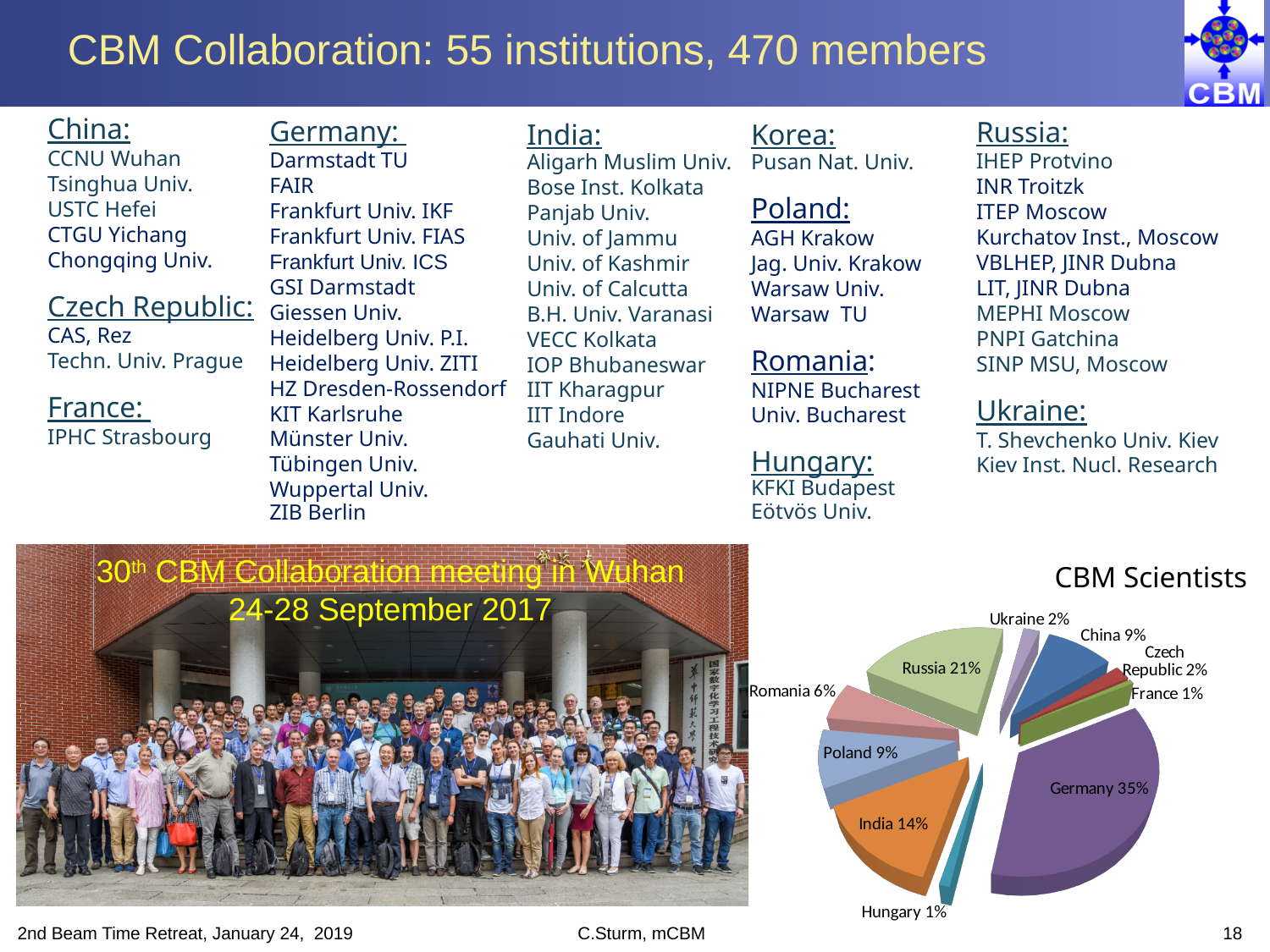
What type of chart is shown on the slide? pie chart What is the title of the pie chart? CBM Scientists What share of CBM scientists does Russia account for in the pie chart? 21% What share of CBM scientists does India account for in the pie chart? 14% Which slice is larger in the pie chart, Russia or India? Russia By how many percentage points does India's share exceed Poland's share in the pie chart? 5 What percentage is shown for Romania in the pie chart? 6% What share of CBM scientists does Germany account for in the pie chart? 35% Which country has the largest slice in the CBM Scientists pie chart? Germany What percentage is shown for Hungary in the pie chart? 1% By how many percentage points does Germany's share exceed Russia's share in the pie chart? 14 What percentage is shown for Ukraine in the pie chart? 2%